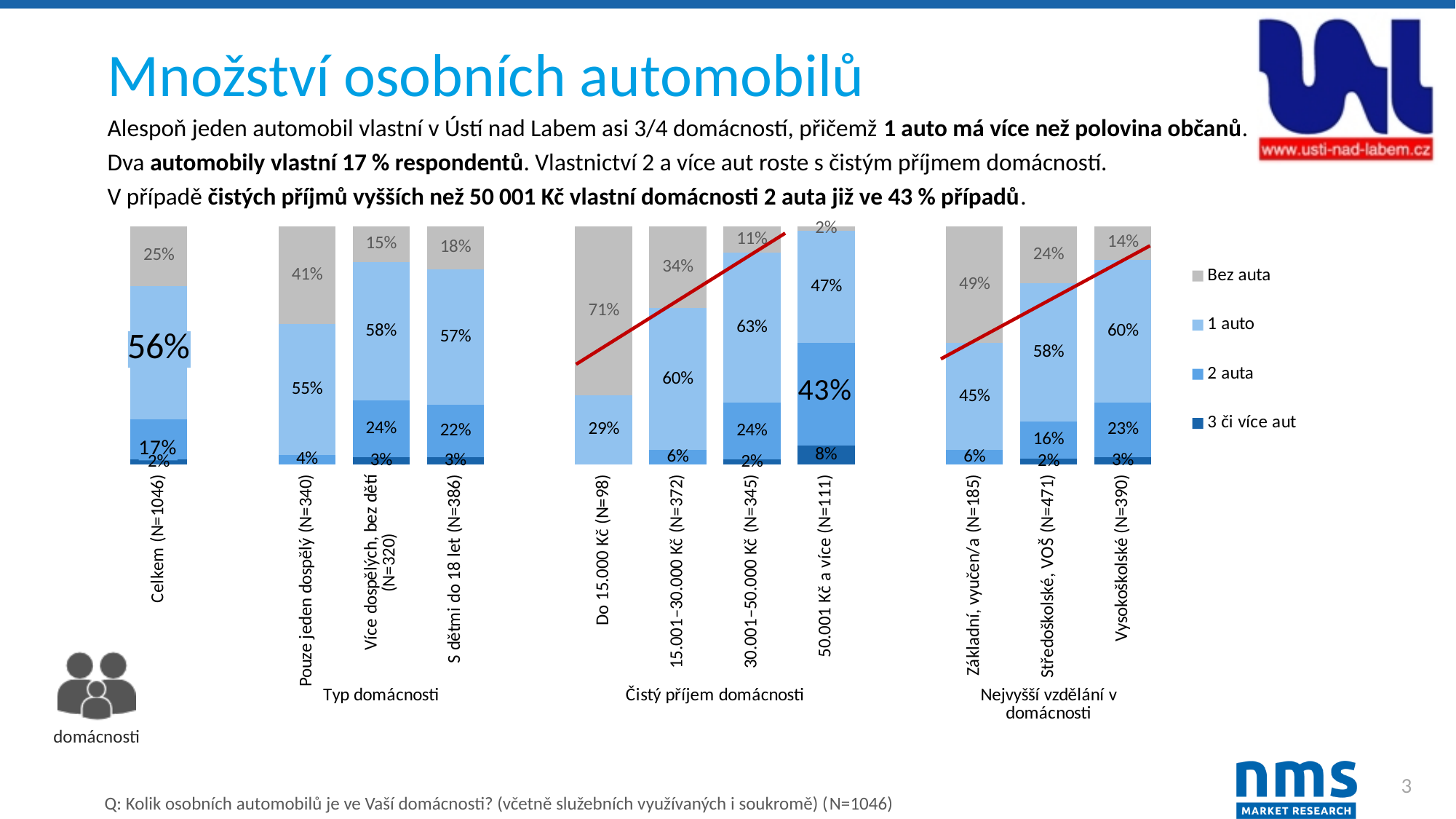
What is the difference between the '2 auta' values for 'Vysokoškolské (N=390)' and 'Základní, vyučen/a (N=185)'? 17% What is the value of 'Bez auta' for the 'Do 15.000 Kč (N=98)' bar? 71% What is the value of '2 auta' for the '50.001 Kč a více (N=111)' bar? 43% Which is larger: the '1 auto' value for 'Více dospělých, bez dětí (N=320)' or for 'Pouze jeden dospělý (N=340)'? Více dospělých, bez dětí (N=320) How many bars (categories) are plotted in the chart? 11 What kind of chart is shown on the slide? Stacked bar chart What is the value of '1 auto' for the 'Celkem (N=1046)' bar? 56% How many series does the legend list? 4 Across the 'Čistý příjem domácnosti' bars from lowest to highest income, does the 'Bez auta' value rise or fall? Fall What is the value of '3 či více aut' for the '50.001 Kč a více (N=111)' bar? 8% Among the 'Nejvyšší vzdělání v domácnosti' bars, which category has the lowest 'Bez auta' value? Vysokoškolské (N=390) Among the 'Čistý příjem domácnosti' bars, which category has the highest 'Bez auta' value? Do 15.000 Kč (N=98)